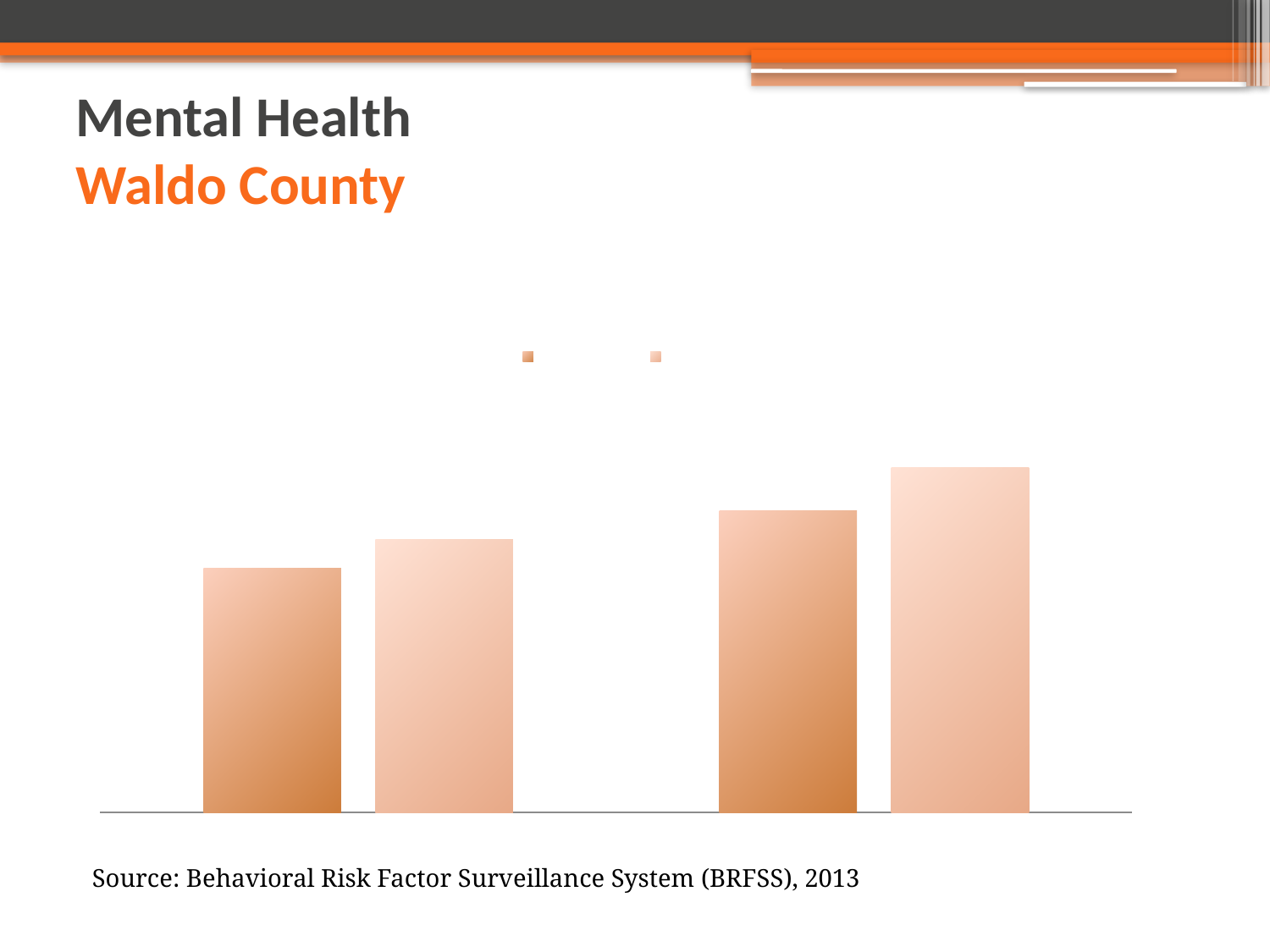
How many series does the legend list? 2 Which bar is the shortest in the chart? the leftmost bar How many groups of bars does the chart show? 2 How many bars are plotted in the chart? 4 What kind of chart is shown on the slide? bar chart In the left group of bars, is the darker orange bar taller or shorter than the lighter bar? shorter Do the bar heights generally rise or fall from left to right across the chart? rise In the right group of bars, is the lighter bar taller or shorter than the darker orange bar? taller What is the title shown above the chart on the slide? Mental Health Waldo County Which bar is the tallest in the chart? the rightmost bar Is the darker orange bar in the right group taller or shorter than the darker orange bar in the left group? taller What data source is cited below the chart? Behavioral Risk Factor Surveillance System (BRFSS), 2013